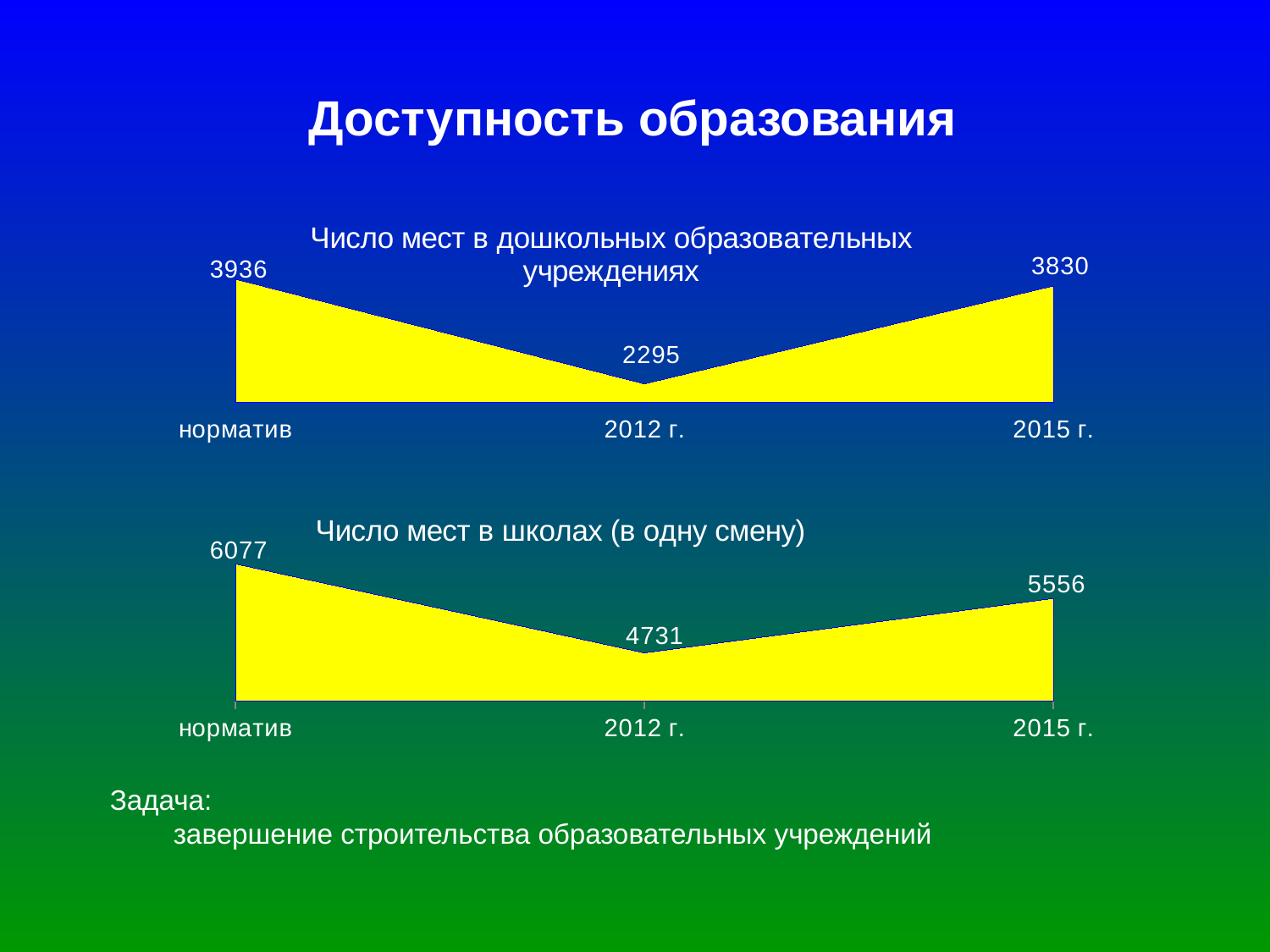
In the top chart (Число мест в дошкольных образовательных учреждениях), what is the difference between the 2015 г. value and the 2012 г. value? 1535 In the bottom chart (Число мест в школах (в одну смену)), what is the value for норматив? 6077 In the bottom chart (Число мест в школах (в одну смену)), which category has the highest value? норматив In the top chart (Число мест в дошкольных образовательных учреждениях), what is the value for норматив? 3936 In the top chart (Число мест в дошкольных образовательных учреждениях), what is the value for 2015 г.? 3830 What kind of chart is the bottom chart (Число мест в школах (в одну смену))? Area chart In the top chart (Число мест в дошкольных образовательных учреждениях), what is the value for 2012 г.? 2295 In the bottom chart (Число мест в школах (в одну смену)), which is larger: the value for 2012 г. or the value for 2015 г.? 2015 г. In the top chart (Число мест в дошкольных образовательных учреждениях), which category has the lowest value? 2012 г. In the bottom chart (Число мест в школах (в одну смену)), what is the difference between the норматив value and the 2015 г. value? 521 In the bottom chart (Число мест в школах (в одну смену)), what is the value for 2015 г.? 5556 How many categories are shown on the x axis of the top chart (Число мест в дошкольных образовательных учреждениях)? 3